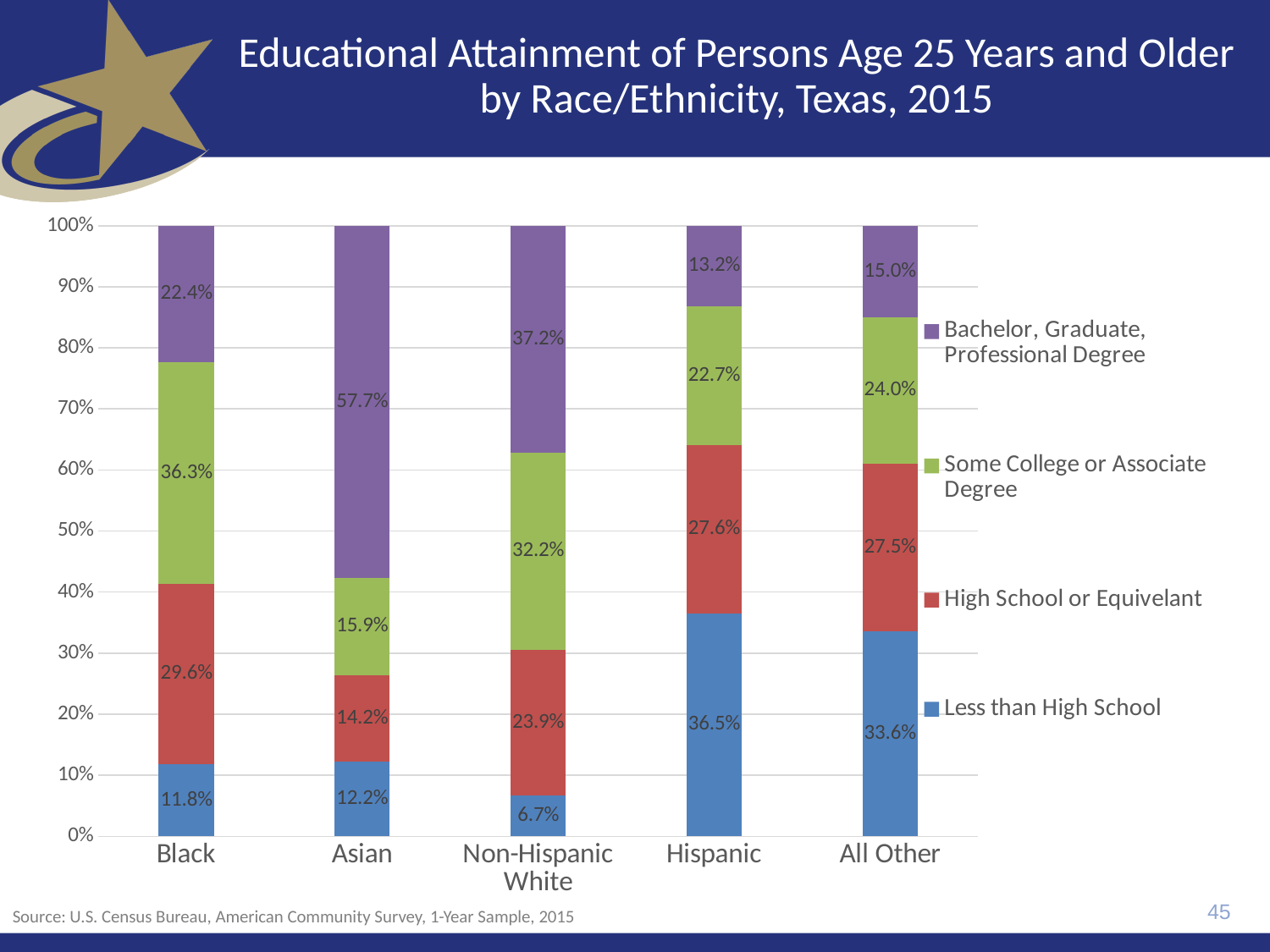
How many series does the legend list? 4 What kind of chart is shown on the slide? Stacked bar chart Which race/ethnicity group has the highest Less than High School percentage? Hispanic How many race/ethnicity categories are shown on the x axis? 5 What percentage of Asians age 25 and older have a Bachelor, Graduate, or Professional Degree? 57.7% Which is larger, the Some College or Associate Degree value for Non-Hispanic White or for All Other? Non-Hispanic White What is the difference between the Bachelor, Graduate, Professional Degree percentages for Asian and Black? 35.3% What is the High School or Equivelant value for Hispanic? 27.6% Which race/ethnicity group has the lowest Bachelor, Graduate, Professional Degree percentage? Hispanic Which colour represents Less than High School in the chart? Blue What is the Some College or Associate Degree value for Black? 36.3% What is the Less than High School value for Non-Hispanic White? 6.7%